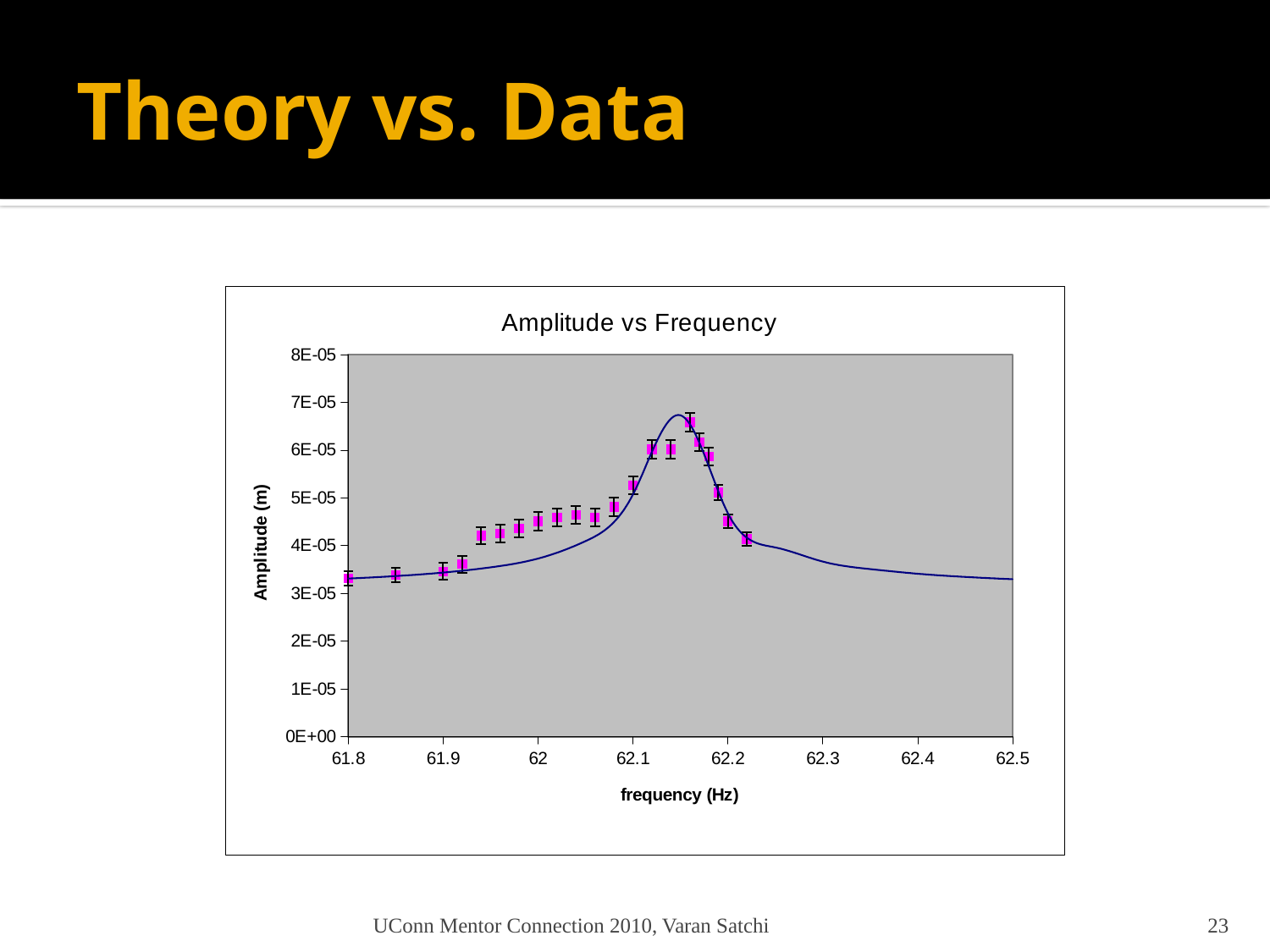
What is the title of the chart? Amplitude vs Frequency Does the amplitude rise or fall as frequency increases from about 62.16 Hz to 62.22 Hz? fall What kind of chart is shown on the slide? Scatter plot with a fitted line What is the maximum value shown on the y axis? 8E-05 Which is larger, the measured amplitude at 61.8 Hz or at 62.1 Hz? 62.1 Hz Is the measured amplitude at 62.2 Hz greater or less than 6E-05? less Is the highest measured amplitude greater or less than 6E-05? greater Is the measured amplitude at 62 Hz greater or less than 4E-05? greater Does the amplitude rise or fall as frequency increases from 61.8 Hz to about 62.15 Hz? rise What is the label of the x axis? frequency (Hz)